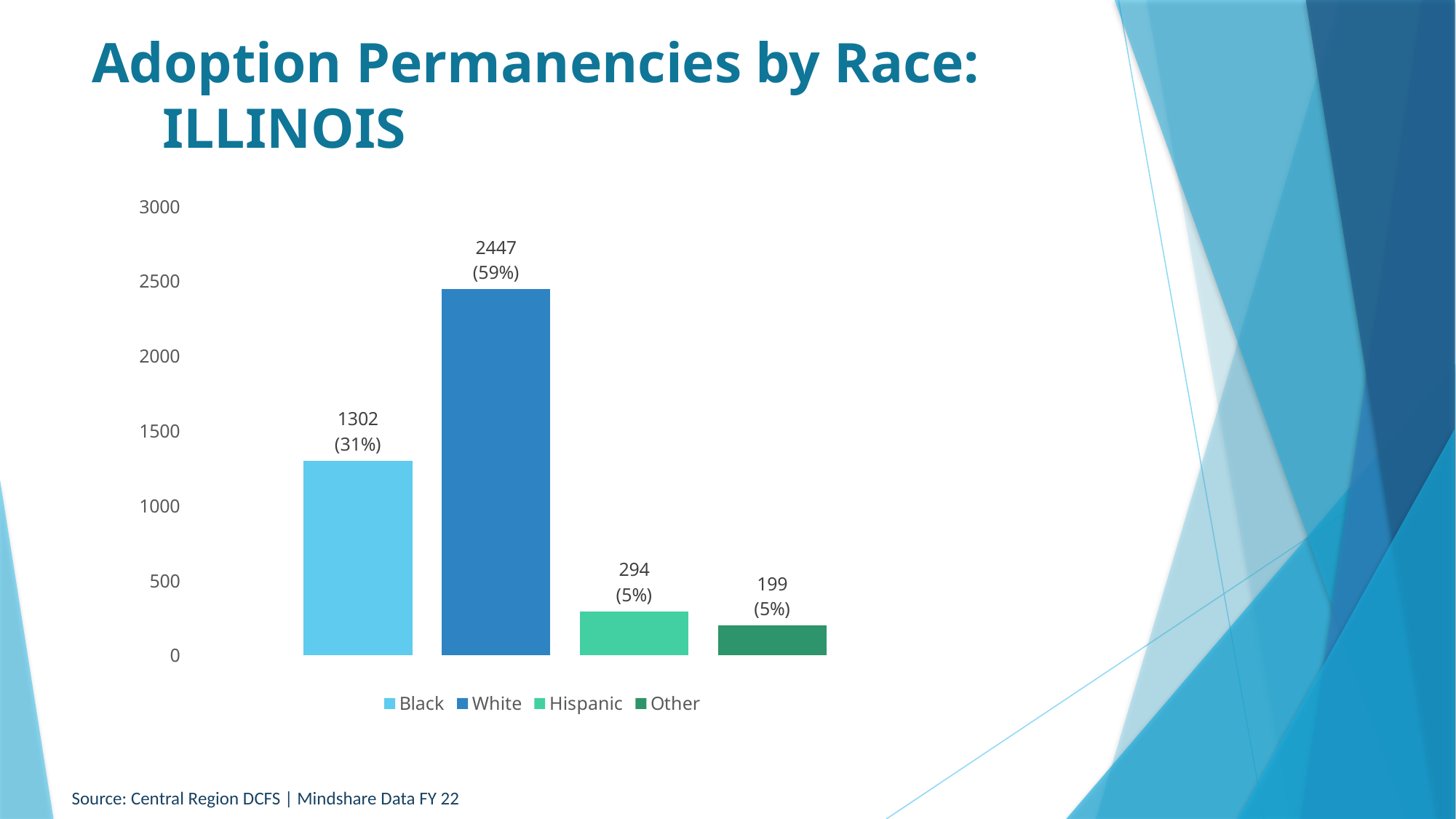
What is the value for Hispanic? 294 (5%) Which is larger, the value for Hispanic or the value for Other? Hispanic What is the value for Other? 199 (5%) Which category has the highest value? White Is the value for Black greater or less than 1000? greater What is the title of the slide? Adoption Permanencies by Race: ILLINOIS How many categories are shown in the chart? 4 Which category has the lowest value? Other What is the value for Black? 1302 (31%) What is the difference between the values for White and Black? 1145 What is the value for White? 2447 (59%) What kind of chart is shown on the slide? Bar chart